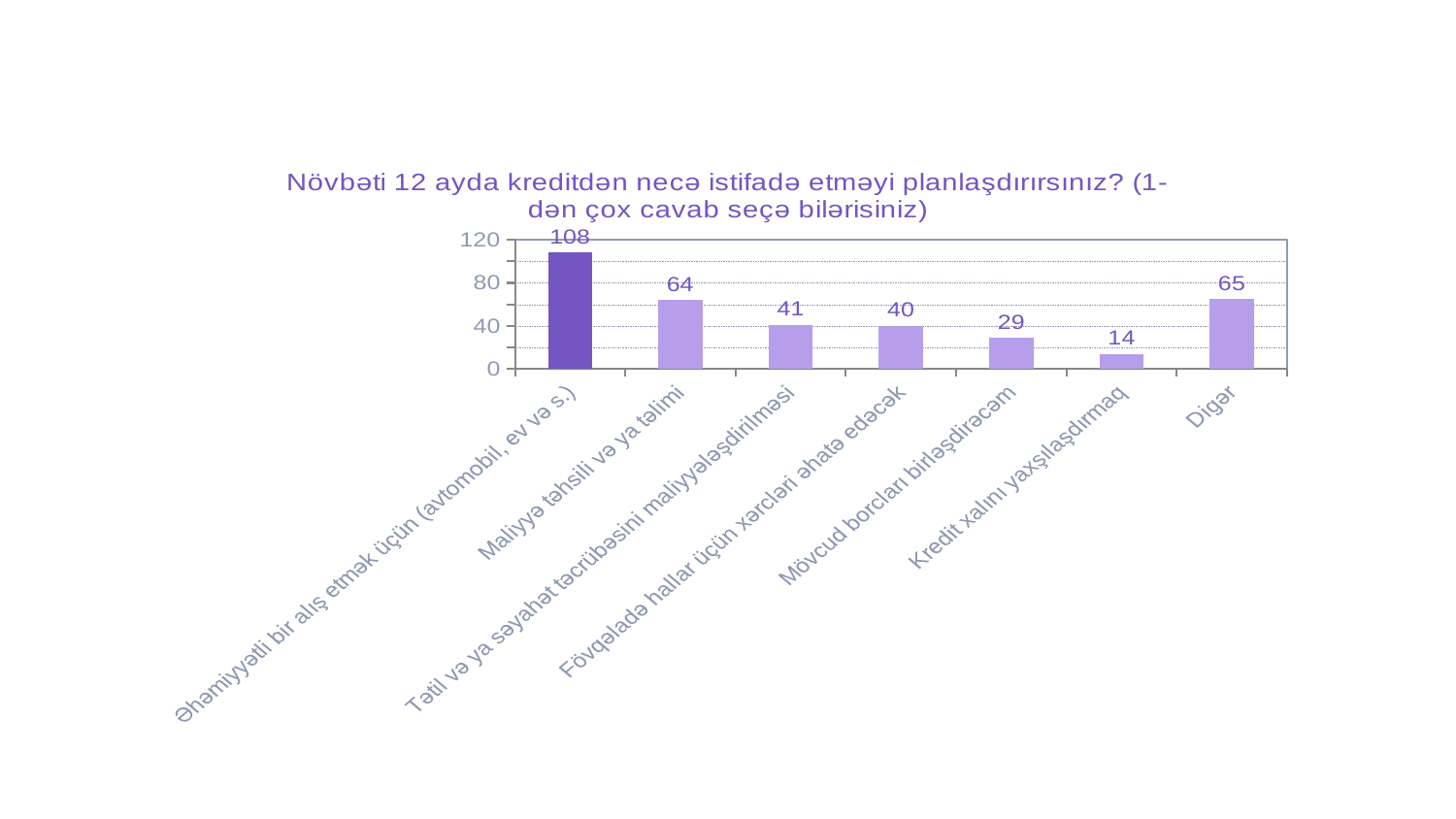
How many categories are shown in the chart? 7 Which category has the lowest value? Kredit xalını yaxşılaşdırmaq Is the value for 'Fövqəladə hallar üçün xərcləri əhatə edəcək' greater or less than 80? less What is the difference between the values for 'Mövcud borcları birləşdirəcəm' and 'Kredit xalını yaxşılaşdırmaq'? 15 What is the value for 'Əhəmiyyətli bir alış etmək üçün (avtomobil, ev və s.)'? 108 What is the difference between the values for 'Əhəmiyyətli bir alış etmək üçün (avtomobil, ev və s.)' and 'Digər'? 43 What is the value for 'Digər'? 65 What kind of chart is shown on the slide? bar chart Which is larger: the value for 'Maliyyə təhsili və ya təlimi' or the value for 'Mövcud borcları birləşdirəcəm'? Maliyyə təhsili və ya təlimi Which category has the highest value? Əhəmiyyətli bir alış etmək üçün (avtomobil, ev və s.) What is the value for 'Kredit xalını yaxşılaşdırmaq'? 14 What is the value for 'Maliyyə təhsili və ya təlimi'? 64